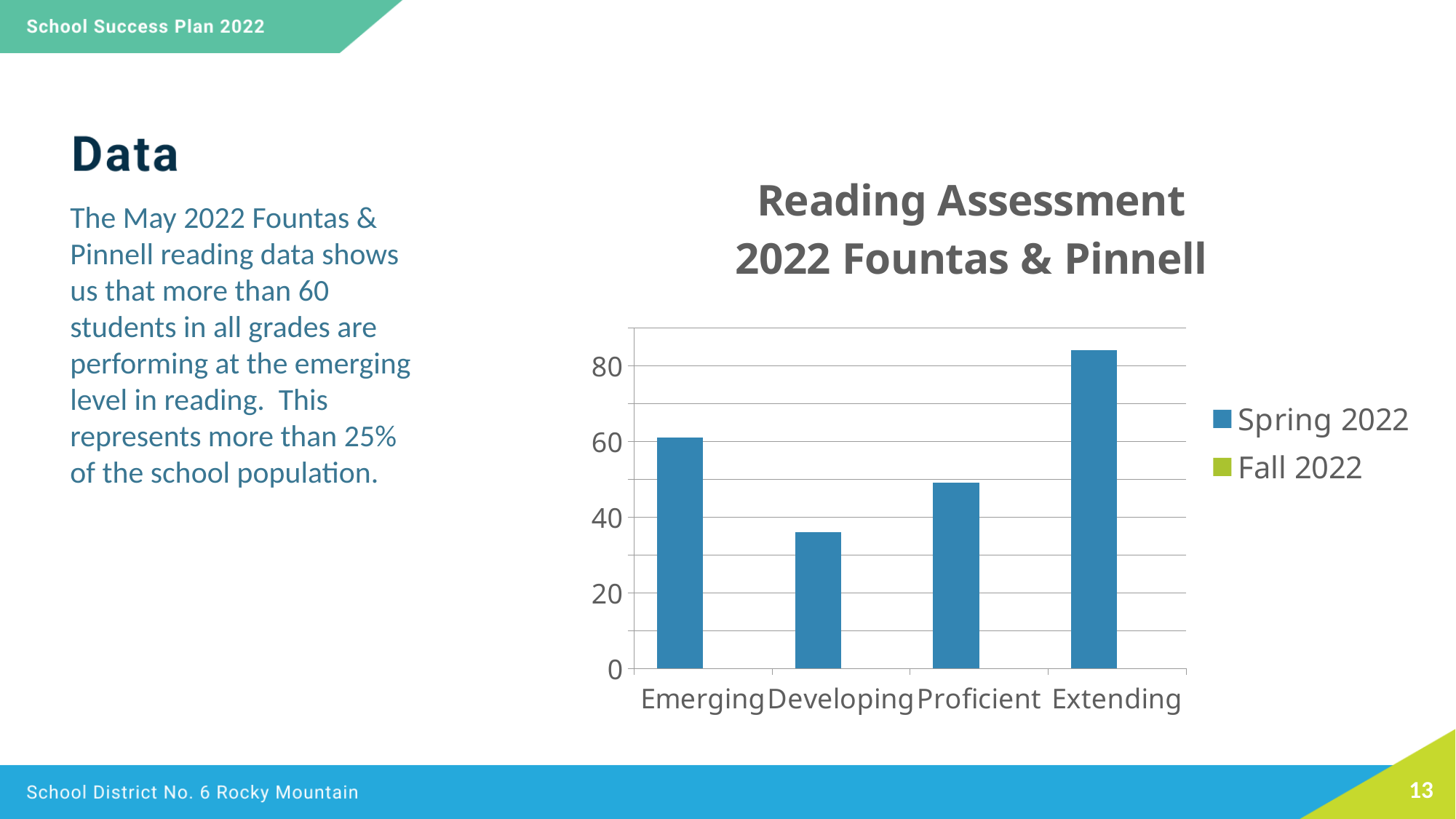
Which category has the highest Spring 2022 value? Extending What is the title of the chart? Reading Assessment 2022 Fountas & Pinnell How many series does the chart legend list? 2 Is the Spring 2022 value for Emerging greater or less than 40? greater Is the Spring 2022 value for Proficient greater or less than 60? less How many categories are shown on the x axis of the chart? 4 What kind of chart is shown on the slide? bar chart Which has a larger Spring 2022 value, Emerging or Proficient? Emerging Which category has the lowest Spring 2022 value? Developing Which series names appear in the chart legend? Spring 2022 and Fall 2022 Is the Spring 2022 value for Developing greater or less than 40? less